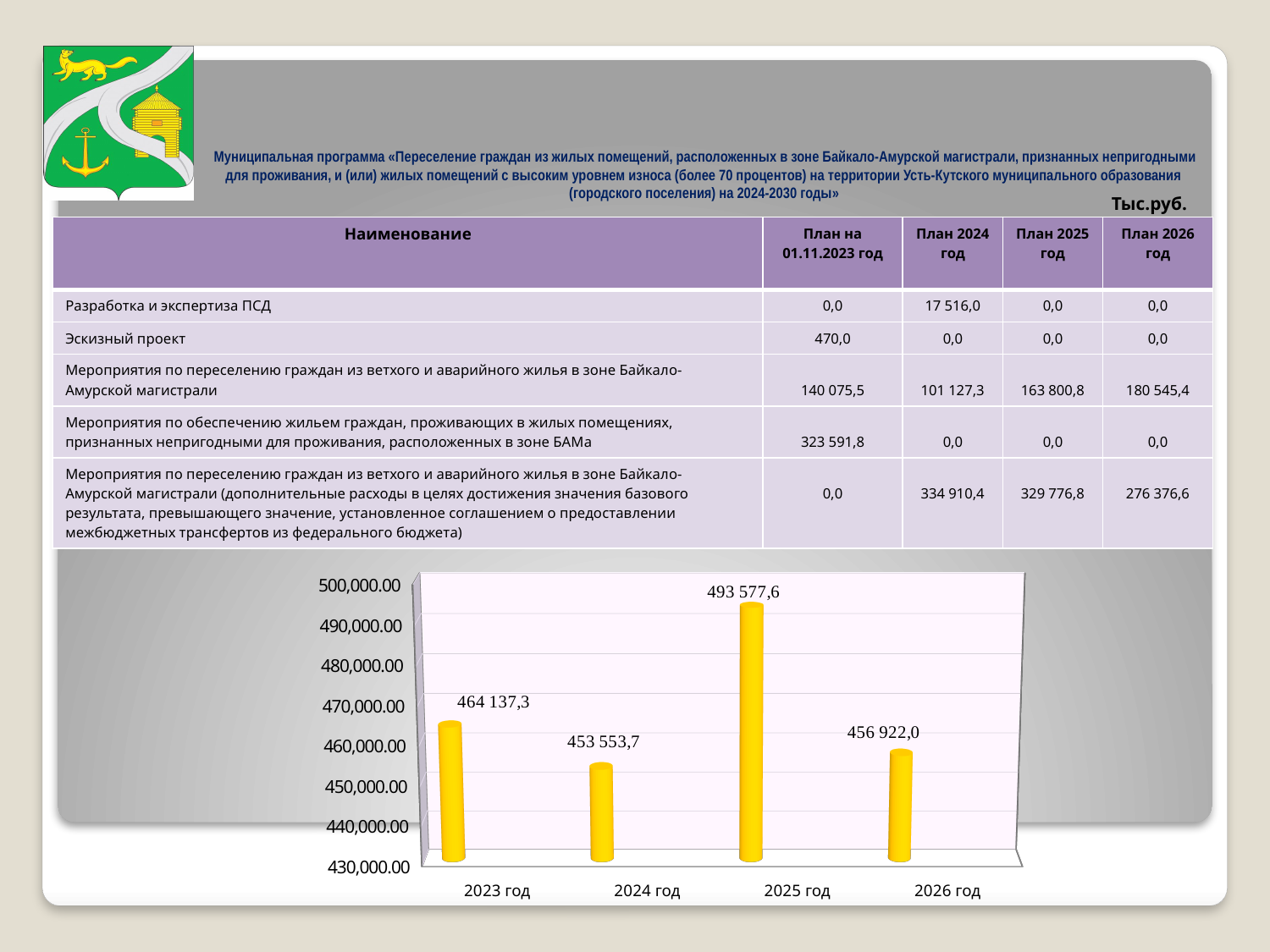
What is the value shown for 2025 год in the bar chart? 493 577,6 What is the value shown for 2026 год in the bar chart? 456 922,0 How many years are shown on the x axis of the bar chart? 4 Is the value for 2025 год in the bar chart greater or less than 480,000.00? greater What is the value shown for 2023 год in the bar chart? 464 137,3 What kind of chart is shown at the bottom of the slide? bar chart What is the difference between the values for 2025 год and 2023 год in the bar chart? 29 440,3 Which year has the lowest value in the bar chart? 2024 год Which year has the highest value in the bar chart? 2025 год What is the difference between the values for 2023 год and 2024 год in the bar chart? 10 583,6 What is the value shown for 2024 год in the bar chart? 453 553,7 Which is larger in the bar chart, the value for 2026 год or the value for 2024 год? 2026 год